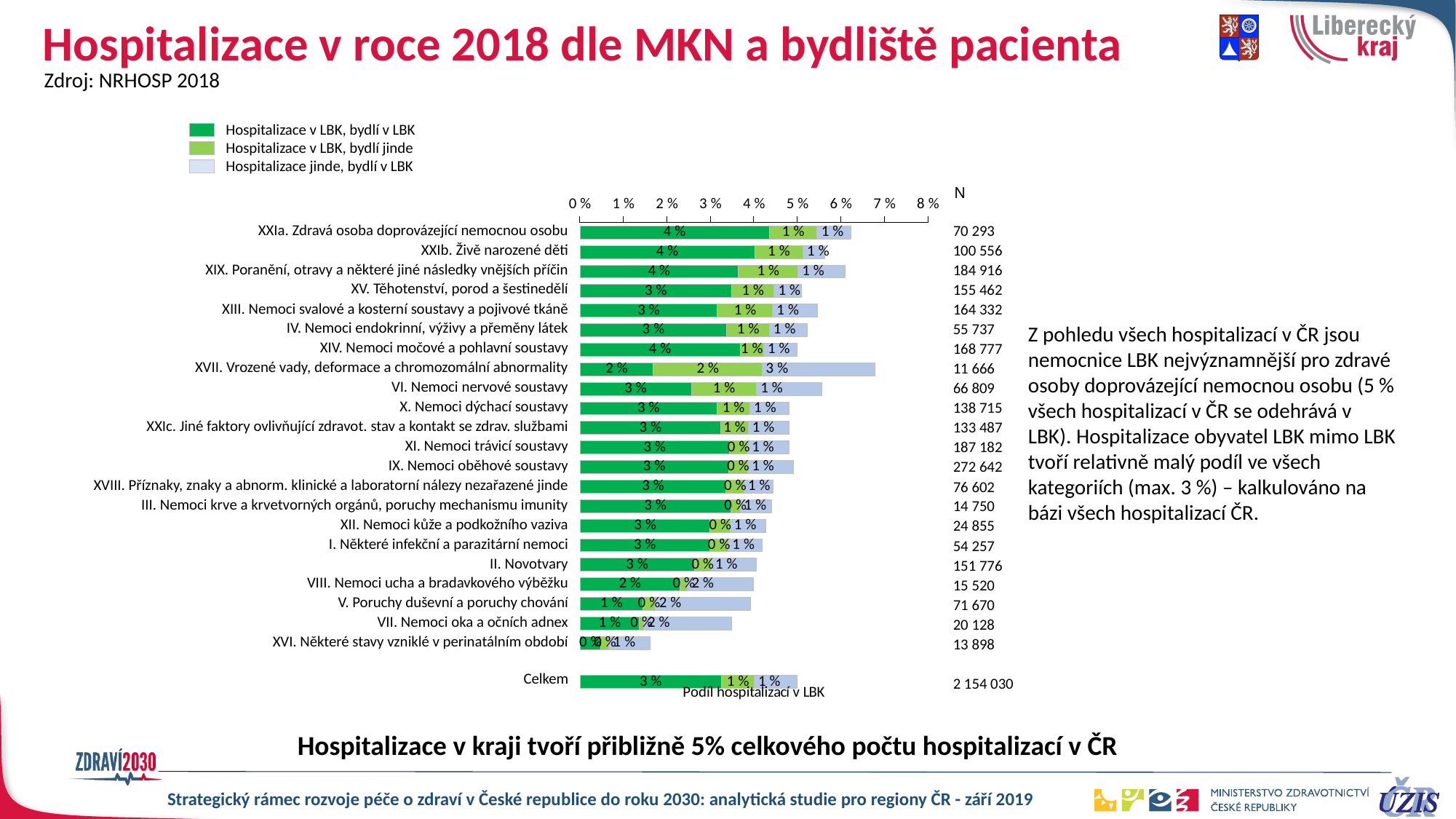
Which category has the longest total bar? XVII. Vrozené vady, deformace a chromozomální abnormality How many series does the legend list? 3 Is the total bar length for 'XVII. Vrozené vady, deformace a chromozomální abnormality' greater or less than 6 %? greater What is the value of 'Hospitalizace v LBK, bydlí v LBK' for 'XXIa. Zdravá osoba doprovázející nemocnou osobu'? 4 % What kind of chart is shown on the slide? Stacked bar chart What is the N value shown for 'XIX. Poranění, otravy a některé jiné následky vnějších příčin'? 184 916 What is the difference between the N values of 'XXIb. Živě narozené děti' (100 556) and 'XXIa. Zdravá osoba doprovázející nemocnou osobu' (70 293)? 30 263 Which category has the shortest total bar? XVI. Některé stavy vzniklé v perinatálním období How many diagnosis categories are plotted, not counting the 'Celkem' row? 22 What is the value of 'Hospitalizace jinde, bydlí v LBK' for 'XVII. Vrozené vady, deformace a chromozomální abnormality'? 3 % What is the N value shown for 'Celkem'? 2 154 030 Which has a larger N value: 'XXIb. Živě narozené děti' or 'XXIa. Zdravá osoba doprovázející nemocnou osobu'? XXIb. Živě narozené děti